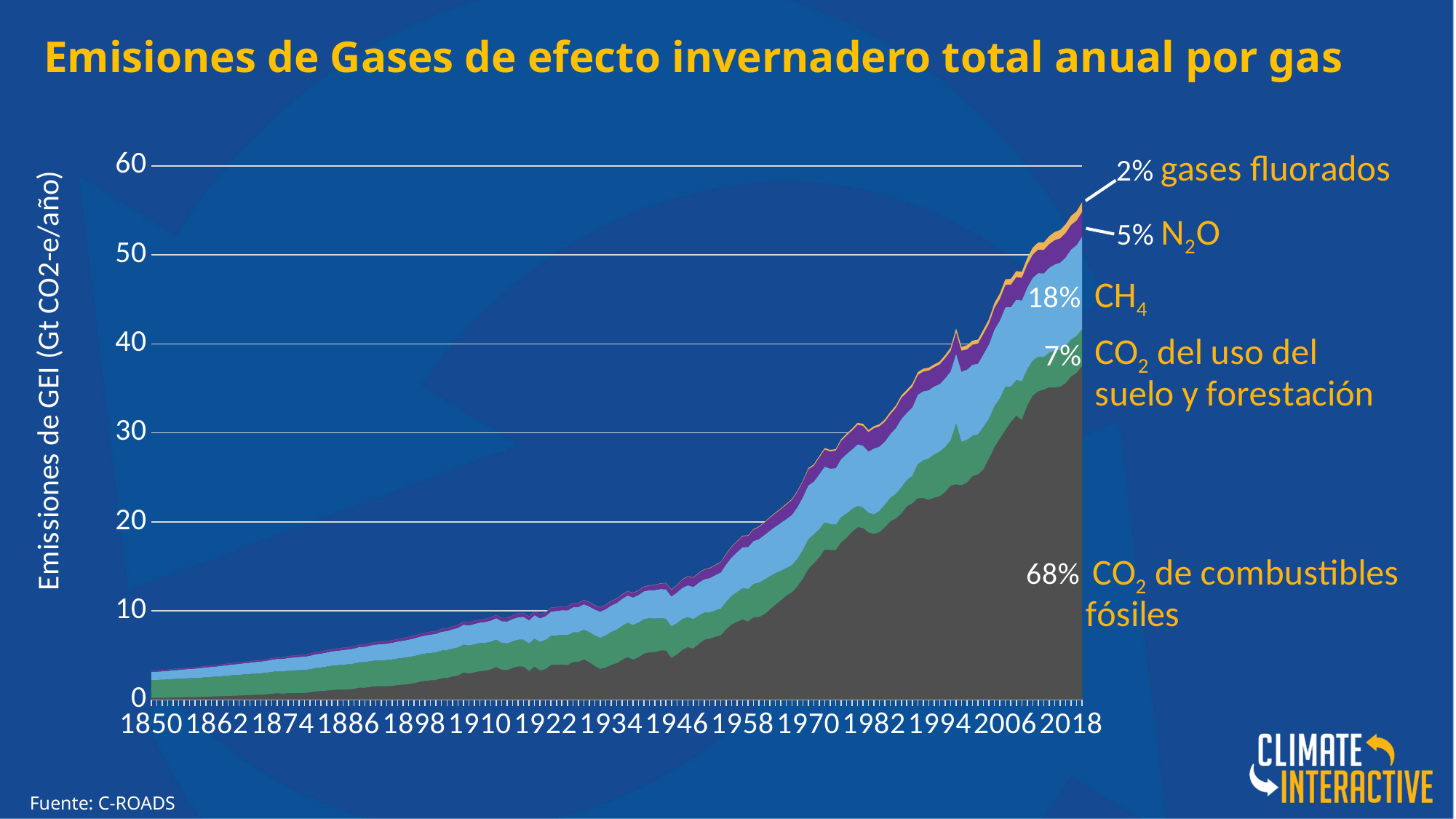
What is the difference in percentage points between the CH4 share and the CO2 del uso del suelo y forestación share? 11 Is the total emissions value at the end of the series (2018) greater or less than 50 Gt CO2-e/año? greater What percentage share is labelled for N2O? 5% What percentage share is labelled for gases fluorados? 2% What is the title of the chart? Emisiones de Gases de efecto invernadero total anual por gas What type of chart is shown on the slide? Stacked area chart What percentage share is labelled for CH4? 18% Which gas category has the largest labelled share of emissions? CO2 de combustibles fósiles How many gas categories are plotted in the chart? 5 Which gas category has the smallest labelled share of emissions? gases fluorados What percentage share is labelled for CO2 de combustibles fósiles? 68% Which has a larger labelled share, N2O or CO2 del uso del suelo y forestación? CO2 del uso del suelo y forestación